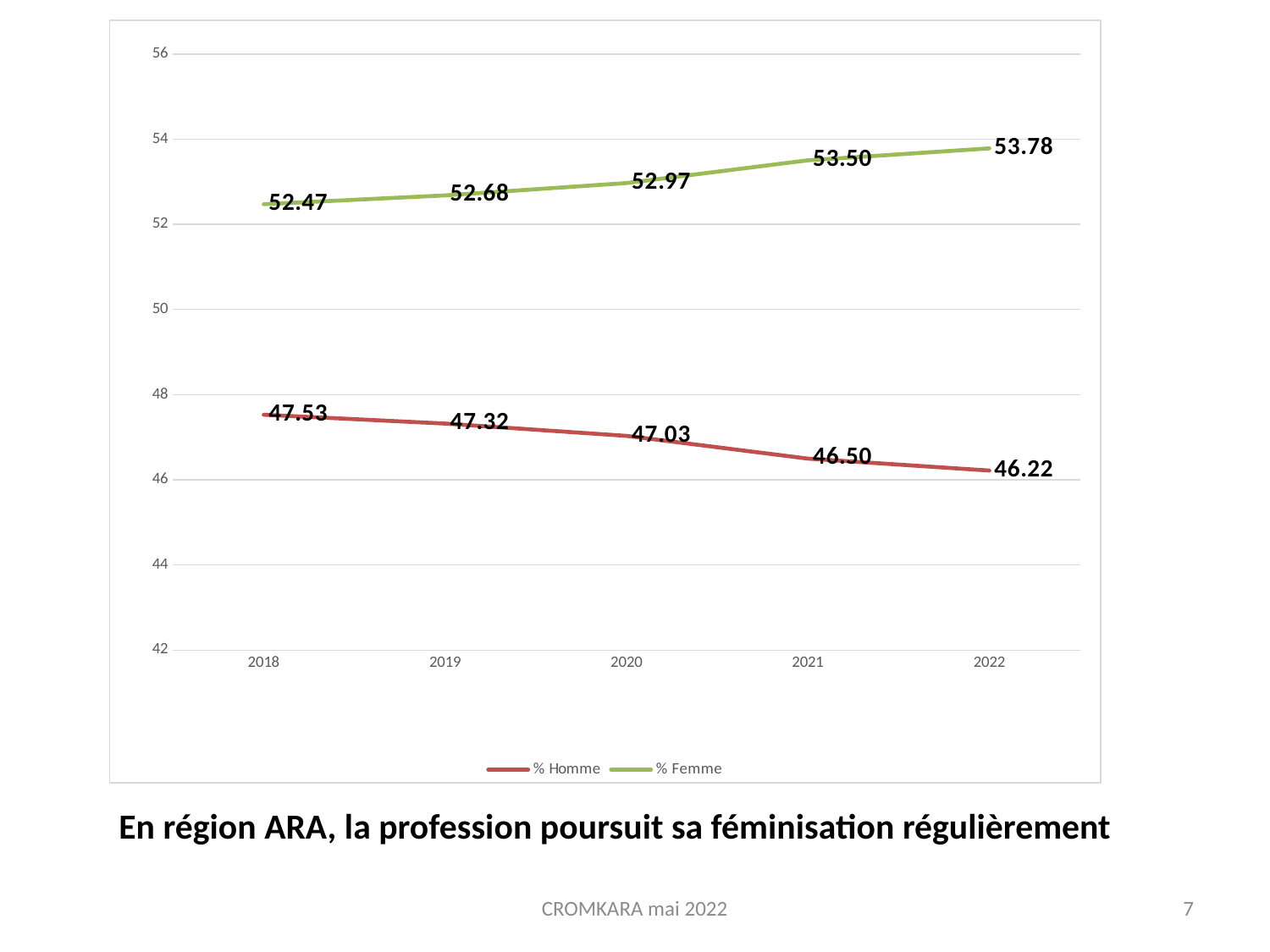
In which year is % Homme lowest? 2022 In which year is % Femme highest? 2022 Which is larger in 2019, % Homme or % Femme? % Femme What is the value of % Homme in 2018? 47.53 Is the value for % Homme in 2020 greater or less than 48? less What kind of chart is shown? line chart What is the value of % Homme in 2022? 46.22 How many series does the legend list? 2 What is the difference between % Femme and % Homme in 2021? 7.00 How many years are shown on the x axis? 5 What is the value of % Femme in 2020? 52.97 Does % Homme rise or fall from 2018 to 2022? fall